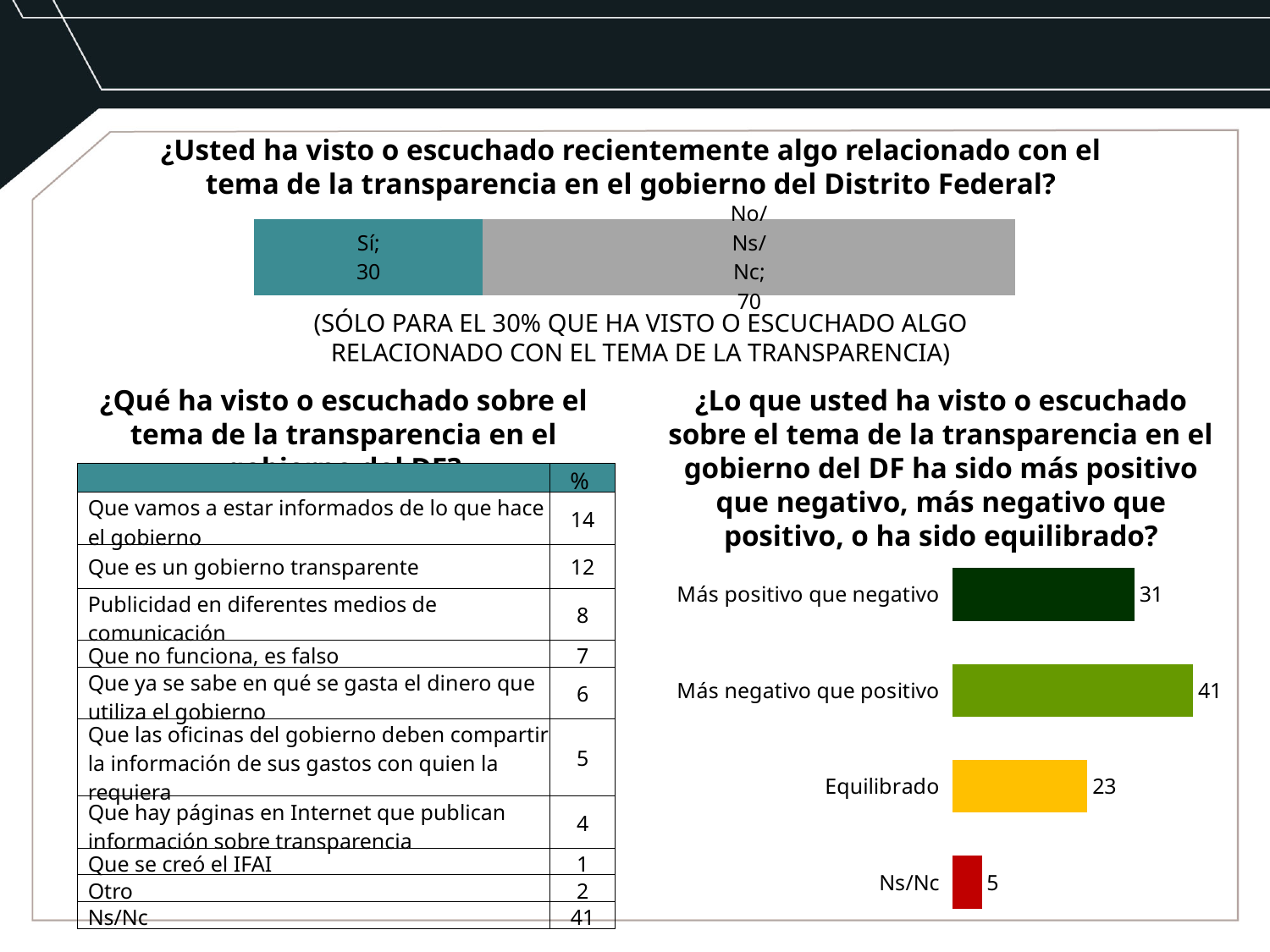
In the bottom-right chart about whether what was seen was more positive or negative, what colour is the bar for "Equilibrado"? Yellow In the top chart under the question about having seen or heard something about transparency in the Distrito Federal government, what is the value for "No/Ns/Nc"? 70 In the bottom-right chart about whether what was seen was more positive or negative, which is larger: "Más positivo que negativo" or "Equilibrado"? Más positivo que negativo In the bottom-right chart about whether what was seen was more positive or negative, which category has the lowest value? Ns/Nc What kind of chart is the bottom-right chart about whether what was seen was more positive or negative? Bar chart In the bottom-right chart about whether what was seen was more positive or negative, what is the value for "Más negativo que positivo"? 41 In the bottom-right chart about whether what was seen was more positive or negative, which category has the highest value? Más negativo que positivo How many categories are shown in the bottom-right chart about whether what was seen was more positive or negative? 4 In the top chart under the question about having seen or heard something about transparency in the Distrito Federal government, what is the value for "Sí"? 30 In the top chart under the question about having seen or heard something about transparency in the Distrito Federal government, what is the total of the two segments? 100 In the bottom-right chart about whether what was seen was more positive or negative, what is the difference between "Más negativo que positivo" and "Más positivo que negativo"? 10 In the bottom-right chart about whether what was seen was more positive or negative, what is the value for "Equilibrado"? 23